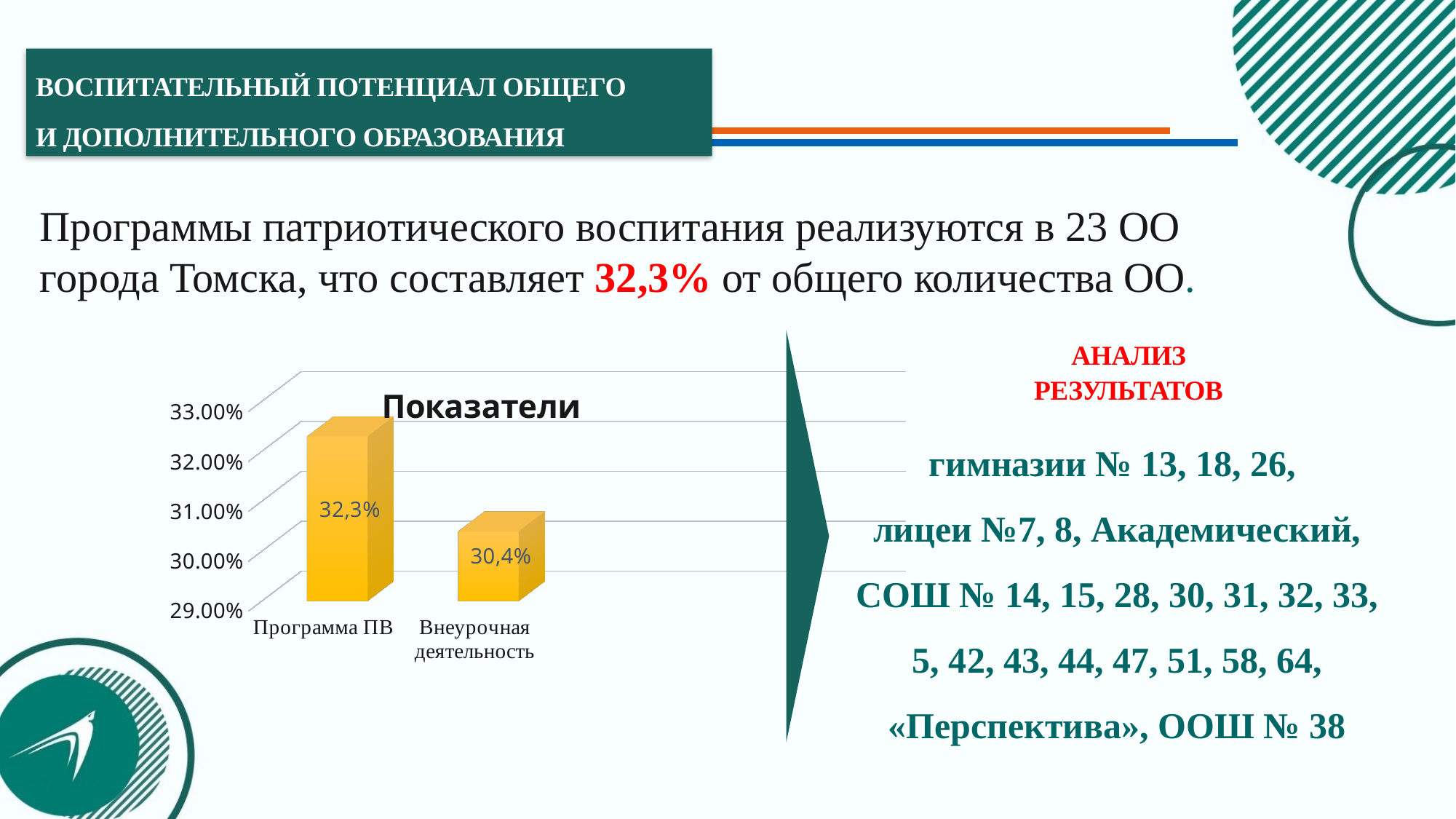
What kind of chart is the Показатели chart? Bar chart What is the value for Внеурочная деятельность in the Показатели chart? 30,4% What is the lowest value shown on the vertical axis of the Показатели chart? 29.00% Which category has the lowest value in the Показатели chart? Внеурочная деятельность Which category has the highest value in the Показатели chart? Программа ПВ What is the value for Программа ПВ in the Показатели chart? 32,3% How many categories are shown in the Показатели chart? 2 What is the difference between the values for Программа ПВ and Внеурочная деятельность in the Показатели chart? 1,9% What is the title of the chart on the slide? Показатели Which is larger in the Показатели chart: the value for Программа ПВ or the value for Внеурочная деятельность? Программа ПВ Is the value for Программа ПВ in the Показатели chart greater or less than 32.00%? greater Is the value for Внеурочная деятельность in the Показатели chart greater or less than 31.00%? less